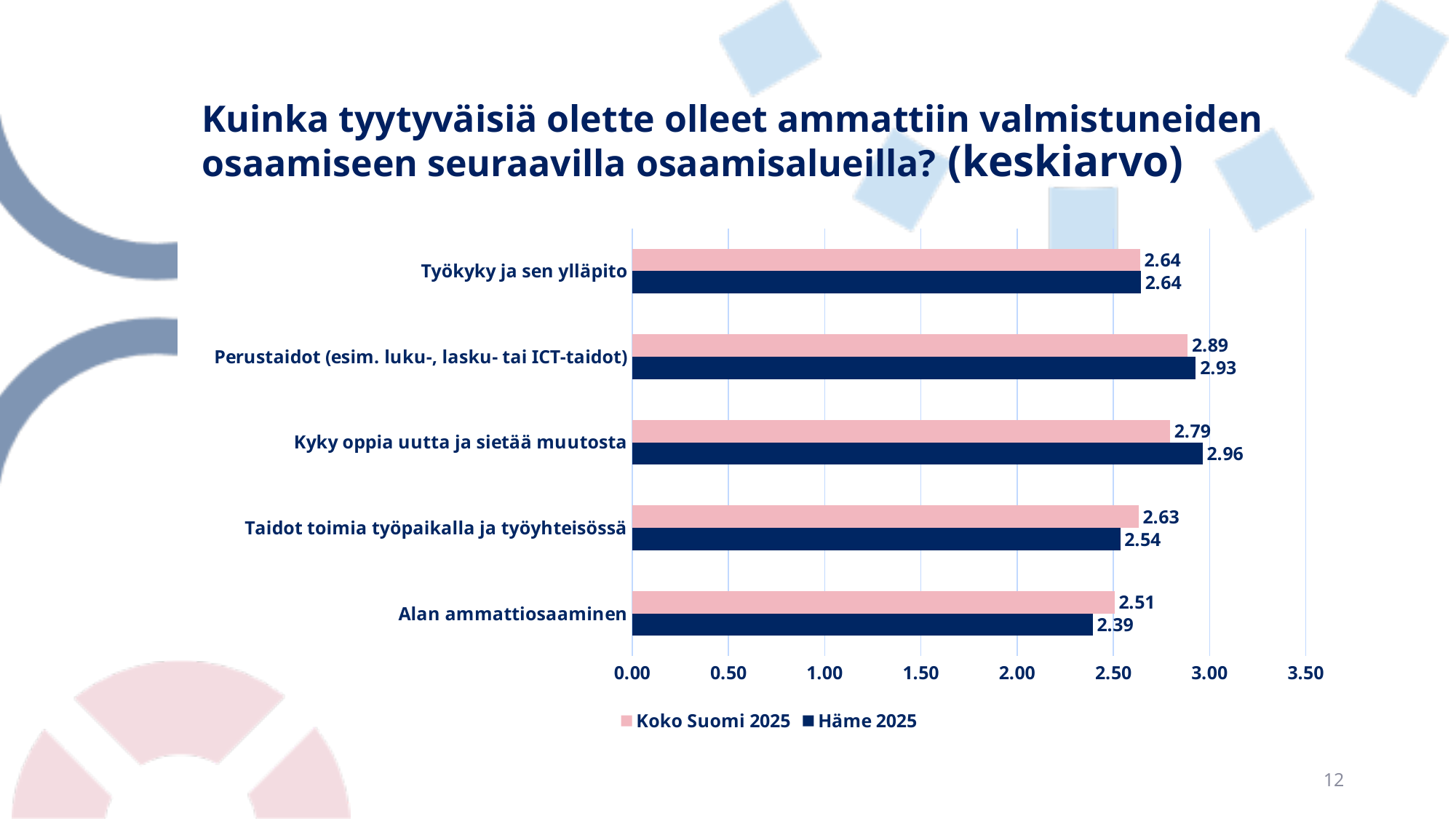
What is the Häme 2025 value for Perustaidot (esim. luku-, lasku- tai ICT-taidot)? 2.93 Which category has the lowest Koko Suomi 2025 value? Alan ammattiosaaminen Is the Häme 2025 value for Alan ammattiosaaminen greater or less than 2.50? less What is the Koko Suomi 2025 value for Alan ammattiosaaminen? 2.51 What kind of chart is shown on the slide? Bar chart Which category has the highest Häme 2025 value? Kyky oppia uutta ja sietää muutosta What is the difference between the Häme 2025 and Koko Suomi 2025 values for Kyky oppia uutta ja sietää muutosta? 0.17 What is the difference between the Koko Suomi 2025 and Häme 2025 values for Alan ammattiosaaminen? 0.12 For Taidot toimia työpaikalla ja työyhteisössä, which series has the larger value, Koko Suomi 2025 or Häme 2025? Koko Suomi 2025 How many series does the legend list? 2 What is the Häme 2025 value for Kyky oppia uutta ja sietää muutosta? 2.96 How many categories are shown on the chart? 5